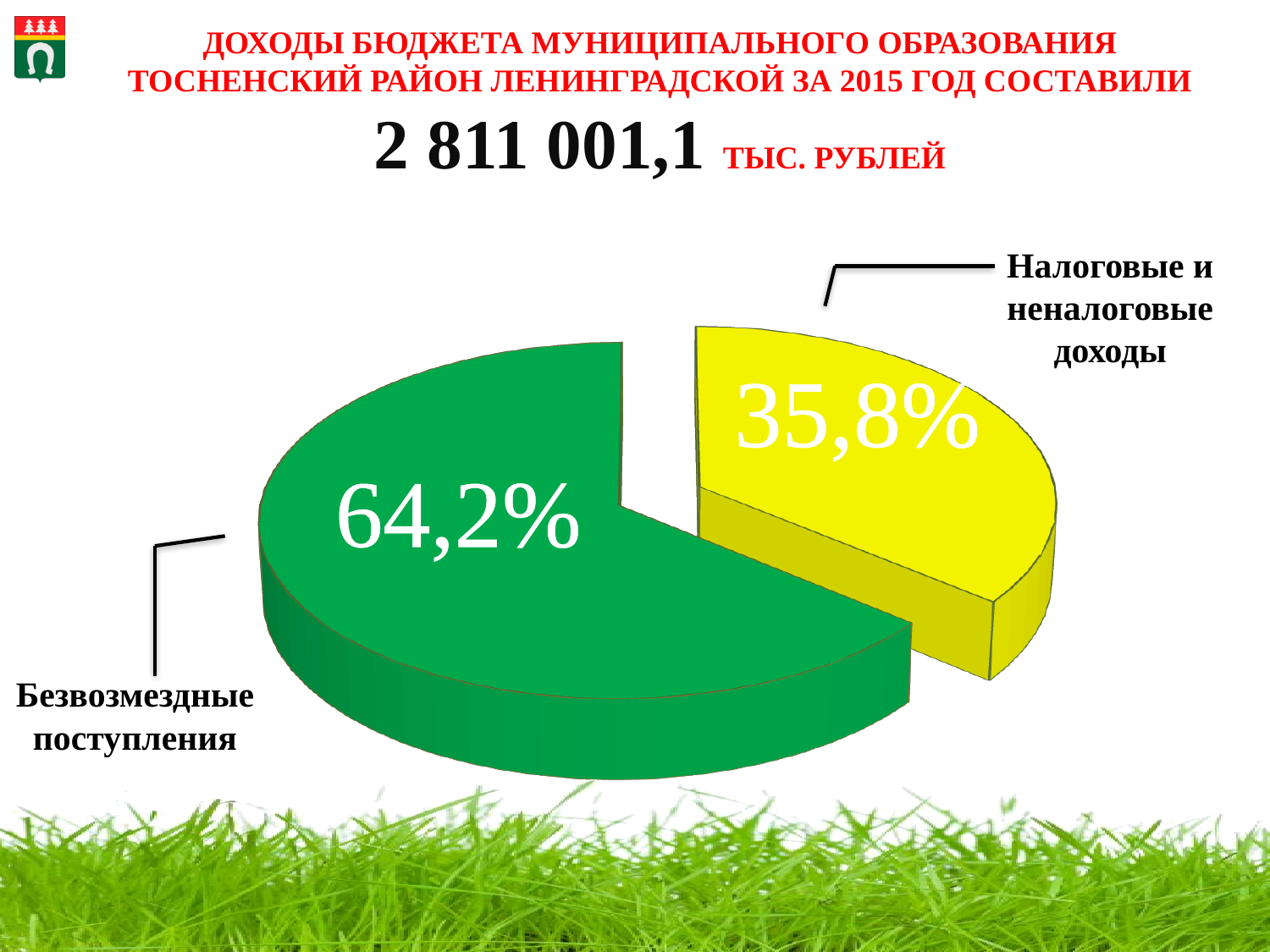
What share of the pie does "Безвозмездные поступления" represent? 64,2% What total budget revenue amount is stated above the chart? 2 811 001,1 тыс. рублей How many slices does the pie chart have? 2 Which is larger: the share for "Безвозмездные поступления" or the share for "Налоговые и неналоговые доходы"? Безвозмездные поступления Which slice of the pie is the smallest? Налоговые и неналоговые доходы What kind of chart is shown on the slide? Pie chart What is the difference in percentage points between the "Безвозмездные поступления" slice and the "Налоговые и неналоговые доходы" slice? 28,4 Which slice of the pie is the largest? Безвозмездные поступления What share of the pie does "Налоговые и неналоговые доходы" represent? 35,8% What colour is the slice labelled "Налоговые и неналоговые доходы"? Yellow